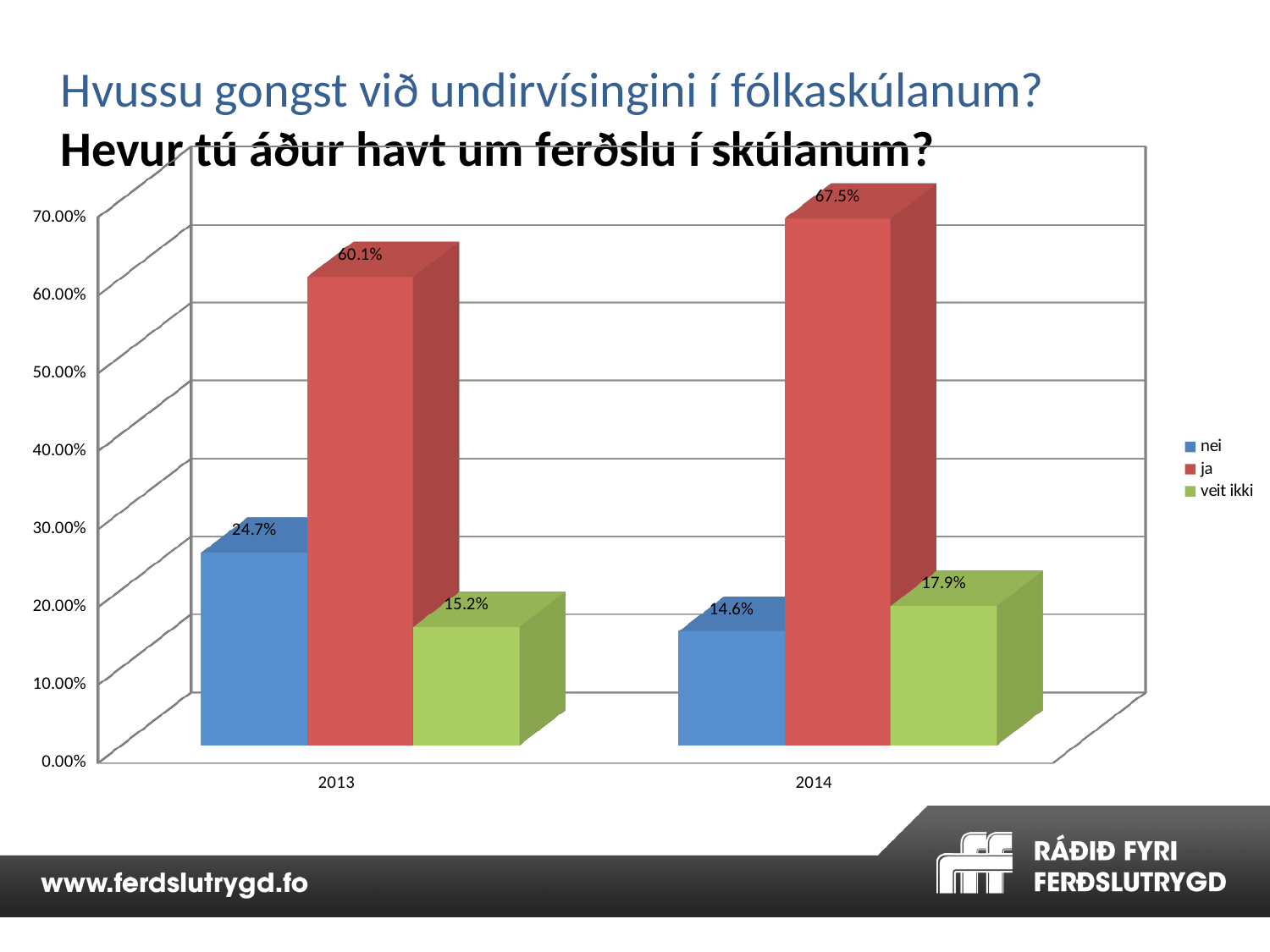
What is the value for "ja" in 2013? 60.1% What is the value for "nei" in 2014? 14.6% Which series has the lowest value in 2013? veit ikki What is the value for "veit ikki" in 2014? 17.9% What is the difference between the "ja" values for 2014 and 2013? 7.4% Does the value for "nei" rise or fall from 2013 to 2014? fall What is the difference between the "nei" values for 2013 and 2014? 10.1% Which is larger: "nei" in 2013 or "veit ikki" in 2014? nei in 2013 What is the value for "veit ikki" in 2013? 15.2% What kind of chart is shown on the slide? bar chart Which series has the highest value in 2014? ja How many series does the legend list? 3